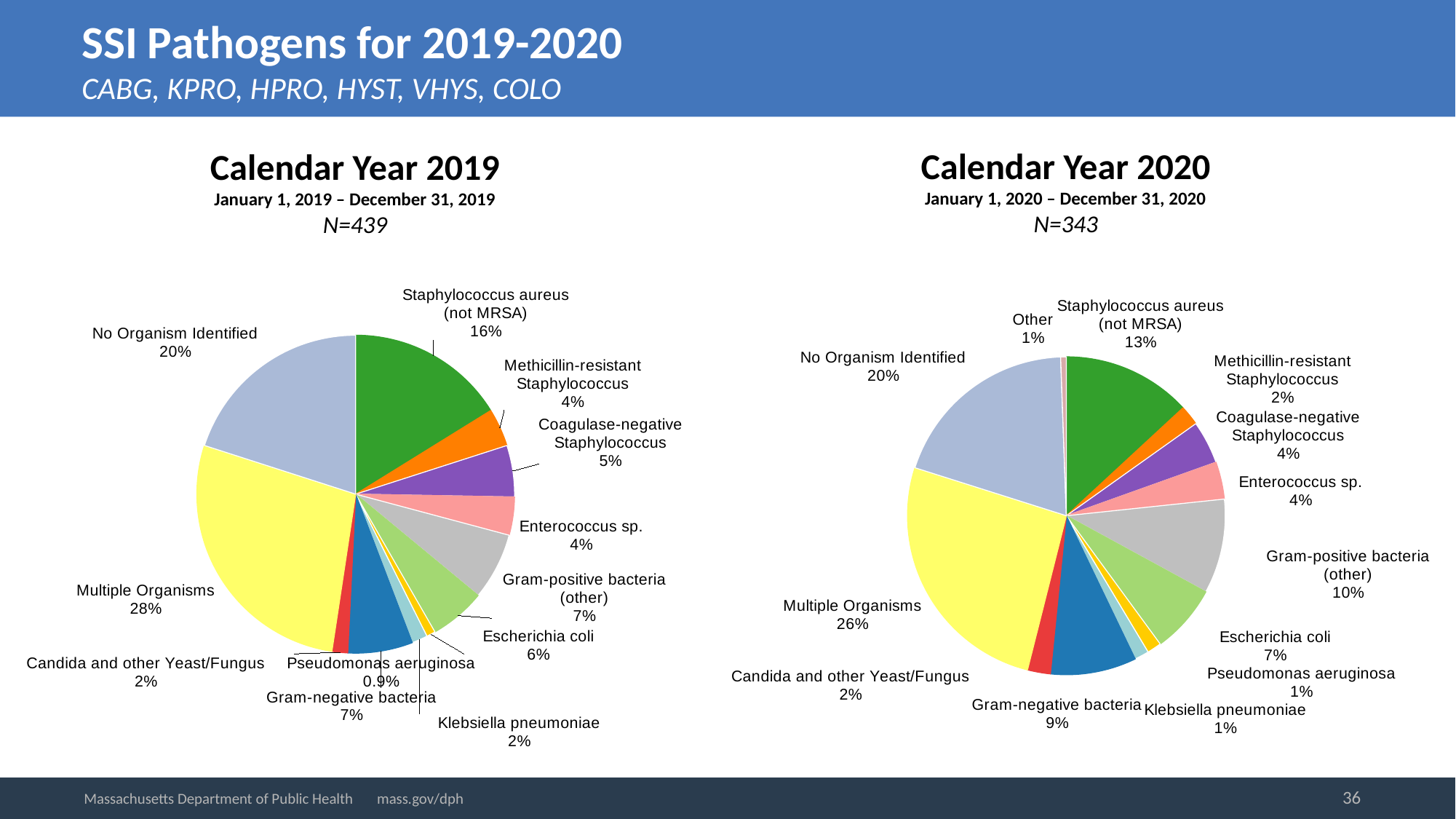
In the Calendar Year 2019 chart, what percentage is Pseudomonas aeruginosa? 0.9% In the Calendar Year 2020 chart, what percentage is Gram-positive bacteria (other)? 10% In the Calendar Year 2020 chart, what percentage is Staphylococcus aureus (not MRSA)? 13% In the Calendar Year 2019 chart, which category has the smallest share? Pseudomonas aeruginosa In the Calendar Year 2019 chart, which category has the largest share? Multiple Organisms In the Calendar Year 2019 chart, what percentage is Multiple Organisms? 28% In the Calendar Year 2020 chart, which is larger: Gram-negative bacteria or Escherichia coli? Gram-negative bacteria What is the difference between the Multiple Organisms share in the Calendar Year 2019 chart and in the Calendar Year 2020 chart? 2 percentage points What kind of chart is the Calendar Year 2019 chart? Pie chart What is the N value shown for the Calendar Year 2020 chart? N=343 In the Calendar Year 2020 chart, which category has the largest share? Multiple Organisms How many categories are shown in the Calendar Year 2020 chart? 13